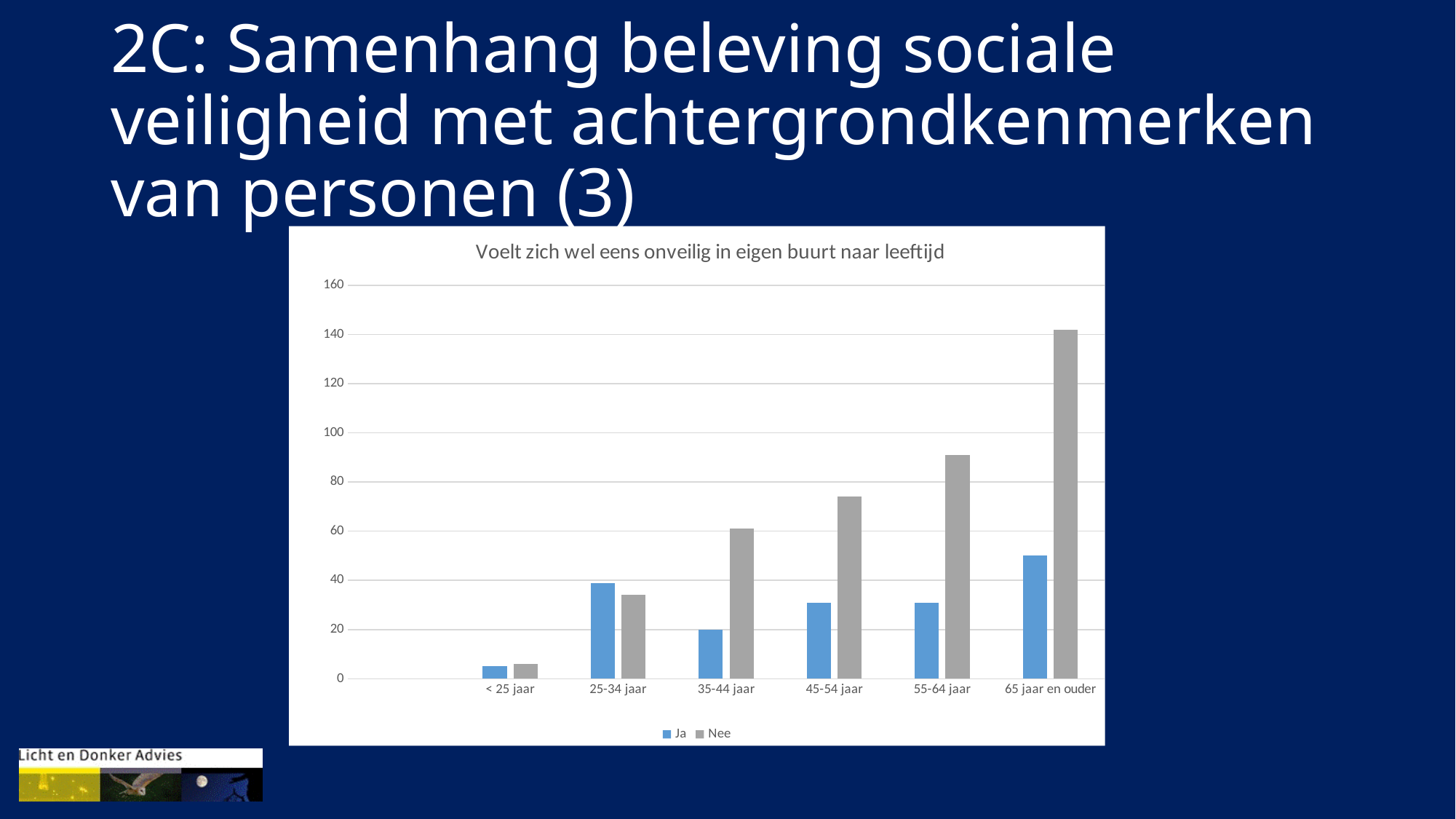
Is the Nee value for 55-64 jaar greater or less than 100? less How many age categories are shown on the x axis of the chart? 6 Is the Ja value for 65 jaar en ouder greater or less than 40? greater Which age category has the highest value for the Ja series? 65 jaar en ouder For the 35-44 jaar category, which series has the larger value, Ja or Nee? Nee Which age category has the highest value for the Nee series? 65 jaar en ouder Which age category has the lowest value for the Ja series? < 25 jaar Which age category has the lowest value for the Nee series? < 25 jaar Is the Nee value for 65 jaar en ouder greater or less than 120? greater What kind of chart is shown on the slide? bar chart Do the Nee values rise or fall as you move from the youngest to the oldest age category? rise How many series does the legend of the chart list? 2